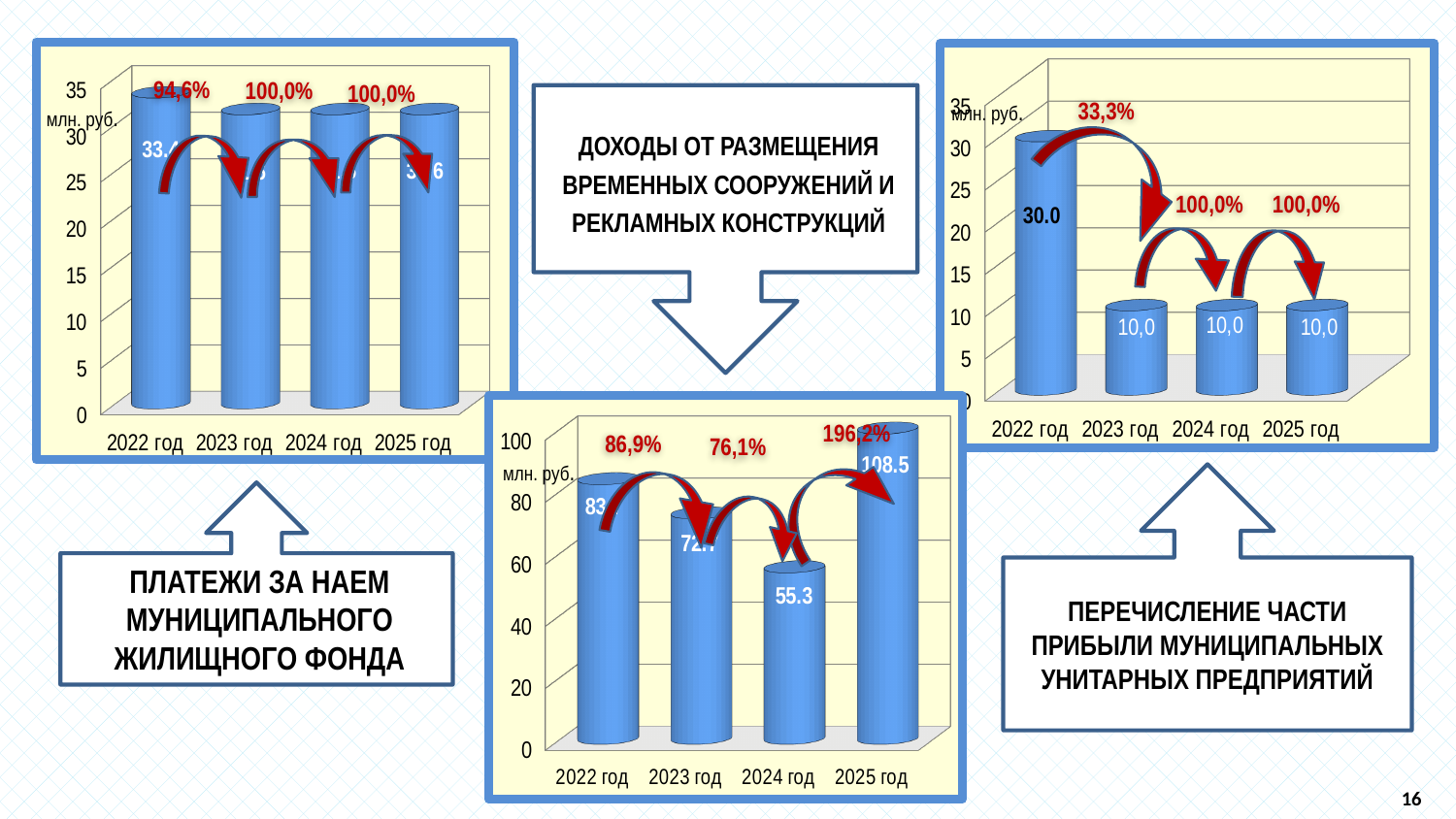
In the chart titled 'ДОХОДЫ ОТ РАЗМЕЩЕНИЯ ВРЕМЕННЫХ СООРУЖЕНИЙ И РЕКЛАМНЫХ КОНСТРУКЦИЙ' (bottom centre), what is the difference between the values for 2025 год and 2024 год? 53.2 In the chart titled 'ДОХОДЫ ОТ РАЗМЕЩЕНИЯ ВРЕМЕННЫХ СООРУЖЕНИЙ И РЕКЛАМНЫХ КОНСТРУКЦИЙ' (bottom centre), what is the value for 2025 год? 108.5 In the chart titled 'ПЛАТЕЖИ ЗА НАЕМ МУНИЦИПАЛЬНОГО ЖИЛИЩНОГО ФОНДА' (left), is the value for 2022 год greater or less than 30? greater In the chart titled 'ДОХОДЫ ОТ РАЗМЕЩЕНИЯ ВРЕМЕННЫХ СООРУЖЕНИЙ И РЕКЛАМНЫХ КОНСТРУКЦИЙ' (bottom centre), what is the value for 2024 год? 55.3 In the chart titled 'ДОХОДЫ ОТ РАЗМЕЩЕНИЯ ВРЕМЕННЫХ СООРУЖЕНИЙ И РЕКЛАМНЫХ КОНСТРУКЦИЙ' (bottom centre), which year has the highest value? 2025 год How many years (categories) are shown in the chart titled 'ПЛАТЕЖИ ЗА НАЕМ МУНИЦИПАЛЬНОГО ЖИЛИЩНОГО ФОНДА' (left)? 4 In the chart titled 'ПЕРЕЧИСЛЕНИЕ ЧАСТИ ПРИБЫЛИ МУНИЦИПАЛЬНЫХ УНИТАРНЫХ ПРЕДПРИЯТИЙ' (right), which year has the highest value? 2022 год What kind of chart is the chart titled 'ПЕРЕЧИСЛЕНИЕ ЧАСТИ ПРИБЫЛИ МУНИЦИПАЛЬНЫХ УНИТАРНЫХ ПРЕДПРИЯТИЙ' (right)? bar chart In the chart titled 'ПЕРЕЧИСЛЕНИЕ ЧАСТИ ПРИБЫЛИ МУНИЦИПАЛЬНЫХ УНИТАРНЫХ ПРЕДПРИЯТИЙ' (right), what is the value for 2022 год? 30.0 In the chart titled 'ПЕРЕЧИСЛЕНИЕ ЧАСТИ ПРИБЫЛИ МУНИЦИПАЛЬНЫХ УНИТАРНЫХ ПРЕДПРИЯТИЙ' (right), what is the value for 2024 год? 10,0 In the chart titled 'ДОХОДЫ ОТ РАЗМЕЩЕНИЯ ВРЕМЕННЫХ СООРУЖЕНИЙ И РЕКЛАМНЫХ КОНСТРУКЦИЙ' (bottom centre), which year has the lowest value? 2024 год In the chart titled 'ПЕРЕЧИСЛЕНИЕ ЧАСТИ ПРИБЫЛИ МУНИЦИПАЛЬНЫХ УНИТАРНЫХ ПРЕДПРИЯТИЙ' (right), what is the difference between the values for 2022 год and 2023 год? 20.0